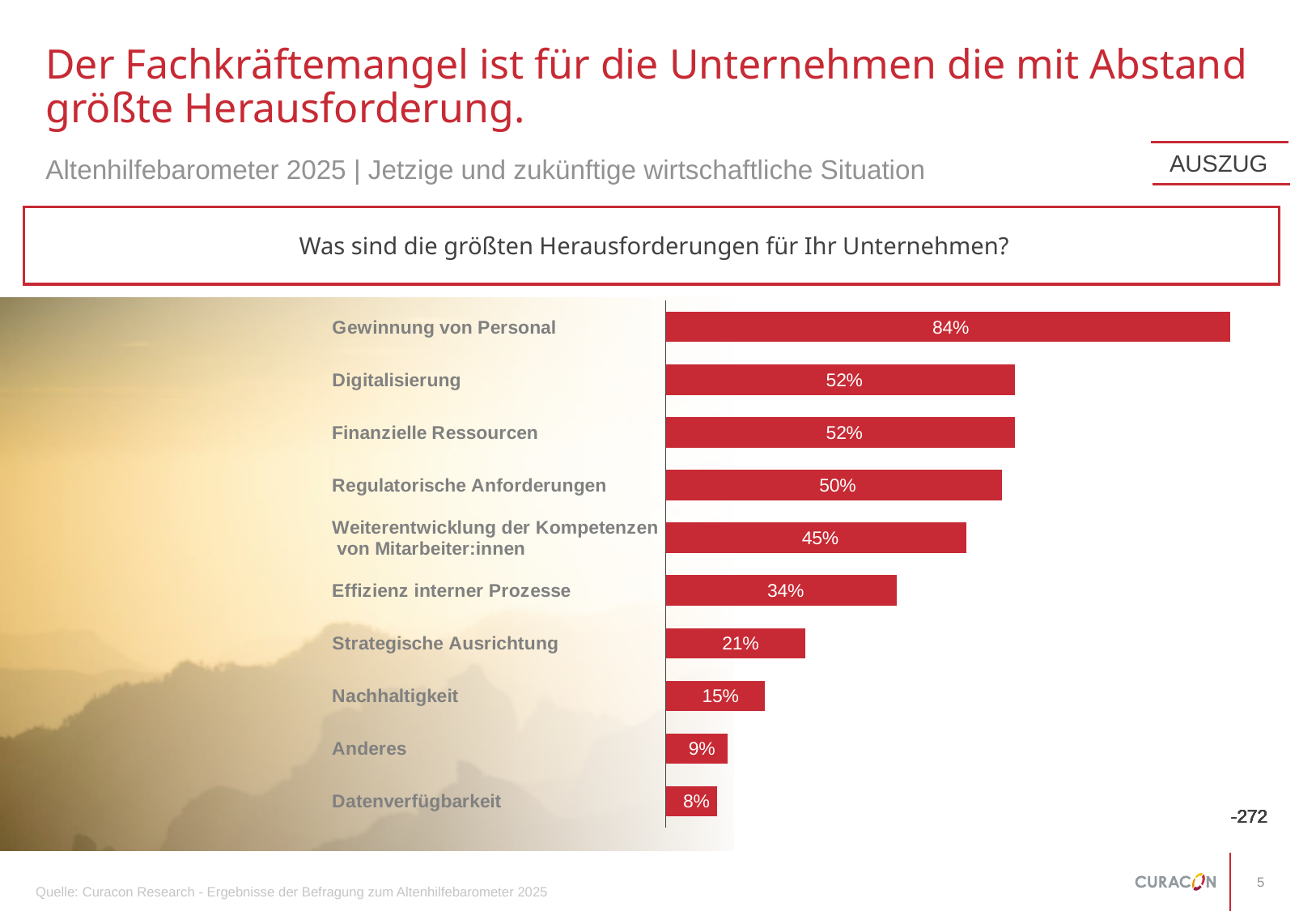
What is the value for Effizienz interner Prozesse? 34% What is the difference between Gewinnung von Personal and Digitalisierung? 32% What is the value for Nachhaltigkeit? 15% Which category has the highest value? Gewinnung von Personal Which category has the lowest value? Datenverfügbarkeit Which is larger, Regulatorische Anforderungen or Weiterentwicklung der Kompetenzen von Mitarbeiter:innen? Regulatorische Anforderungen What kind of chart is shown on the slide? Bar chart What is the difference between Strategische Ausrichtung and Anderes? 12% What question is the chart answering, as shown in the box above it? Was sind die größten Herausforderungen für Ihr Unternehmen? What is the value for Datenverfügbarkeit? 8% What is the value for Gewinnung von Personal? 84% How many categories are shown in the chart? 10